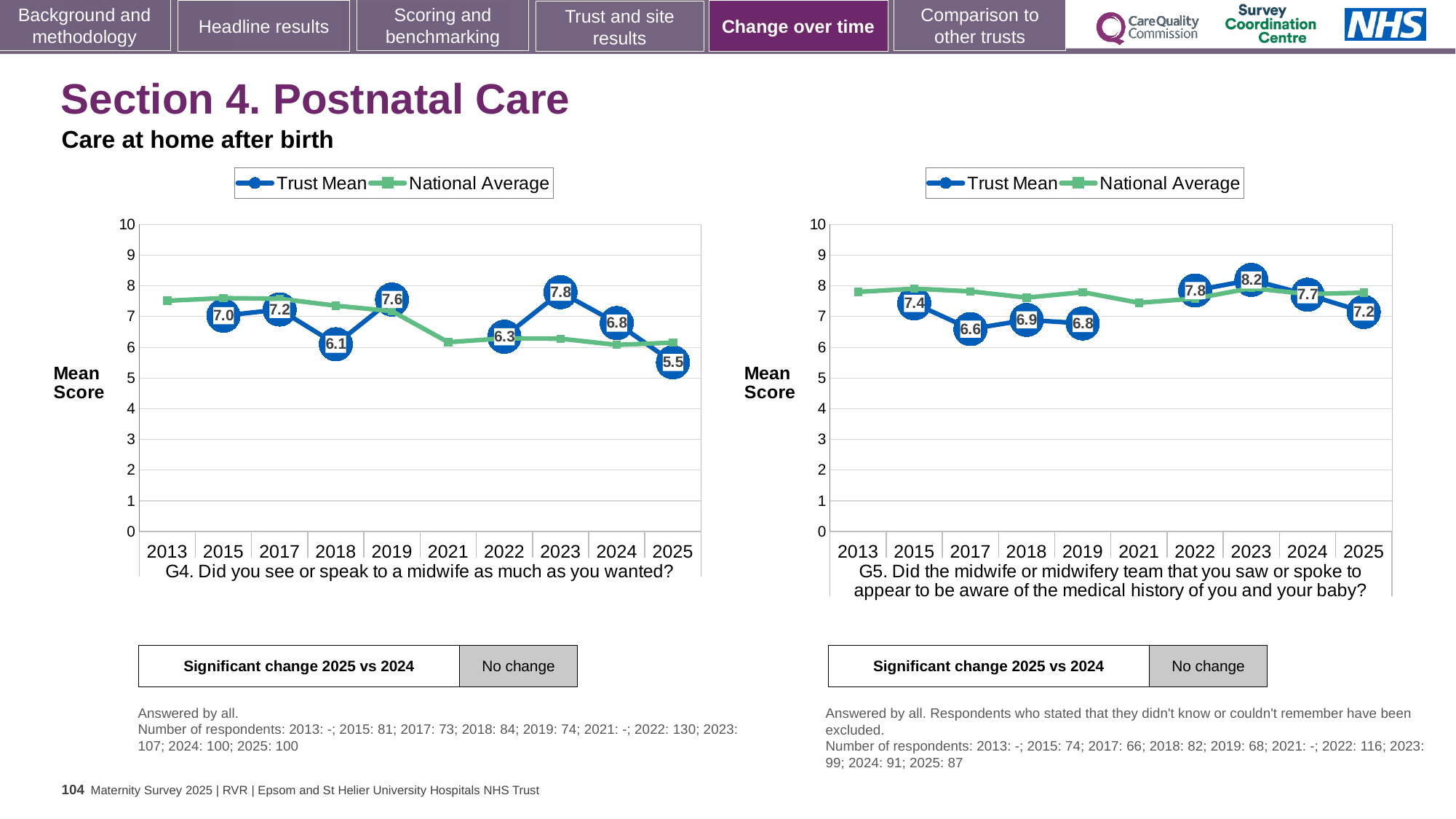
On the G5 chart (right), is the National Average for 2013 greater or less than 7? greater What kind of chart is the G4 chart (left)? Line chart On the G5 chart (right), which is larger, the Trust Mean in 2015 or in 2025? 2015 On the G4 chart (left), what is the Trust Mean score for 2025? 5.5 On the G5 chart (right), in which year is the Trust Mean lowest? 2017 How many years are shown on the x axis of the G5 chart (right)? 10 On the G4 chart (left), what is the Trust Mean score for 2019? 7.6 On the G4 chart (left), what is the difference between the Trust Mean in 2023 and in 2024? 1.0 On the G4 chart (left), in which year is the Trust Mean lowest? 2025 On the G5 chart (right), what is the Trust Mean score for 2023? 8.2 On the G4 chart (left), in which year is the Trust Mean highest? 2023 How many series does the legend of the G4 chart (left) list? 2